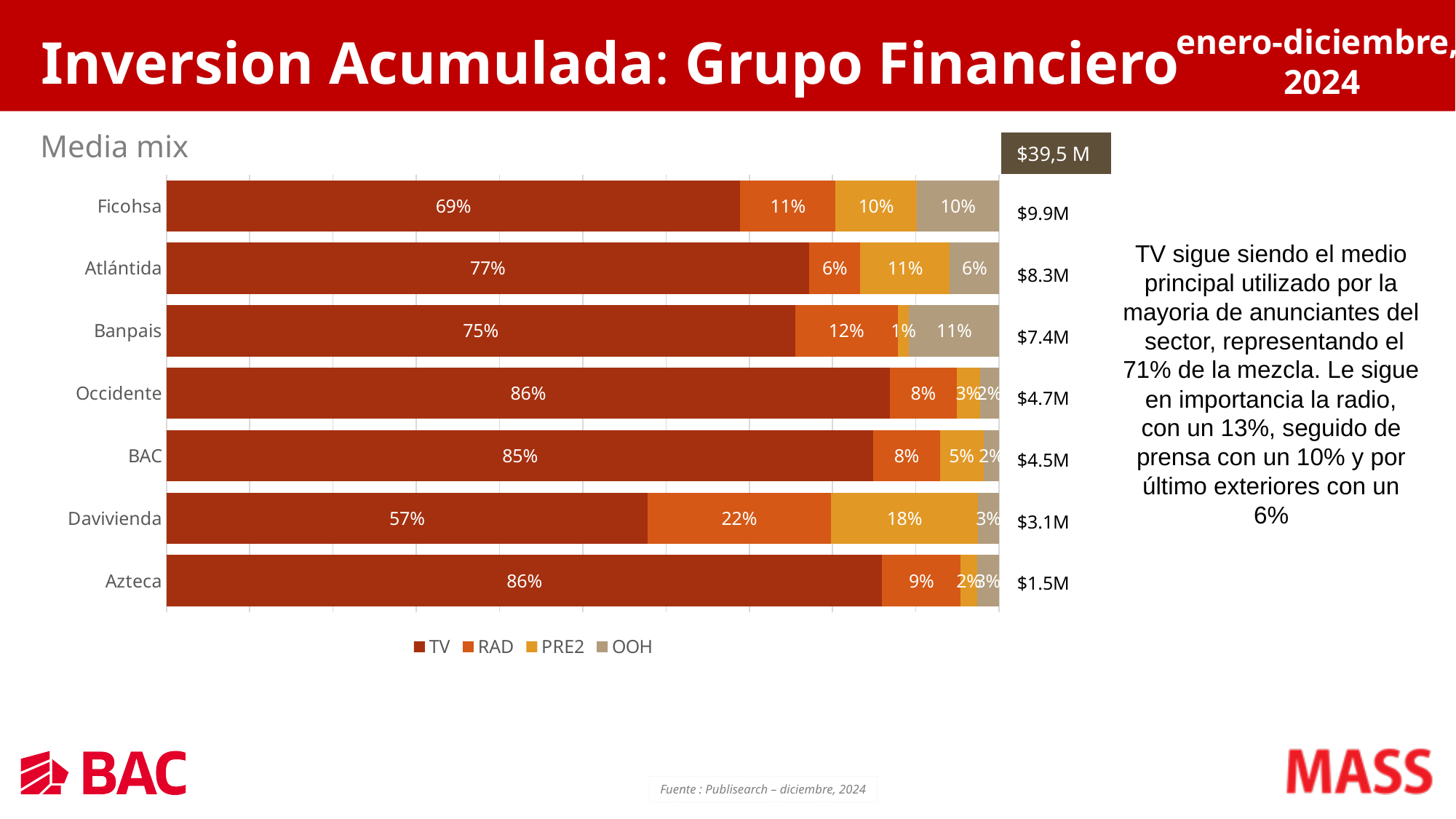
What total investment amount is shown next to the Ficohsa bar? $9.9M What is the difference in percentage points between Ficohsa's TV share and Davivienda's TV share? 12 percentage points What percentage of Ficohsa's media mix is TV? 69% What is the RAD share for Davivienda? 22% Which advertiser has the highest RAD share? Davivienda How many series does the legend list? 4 How many advertisers are shown in the Media mix chart? 7 Which advertiser has the lowest TV share in its media mix? Davivienda What is the OOH share for Banpais? 11% What is the PRE2 share for Davivienda? 18% Which has a larger TV share, Atlántida or Banpais? Atlántida What kind of chart is the Media mix chart? Stacked bar chart